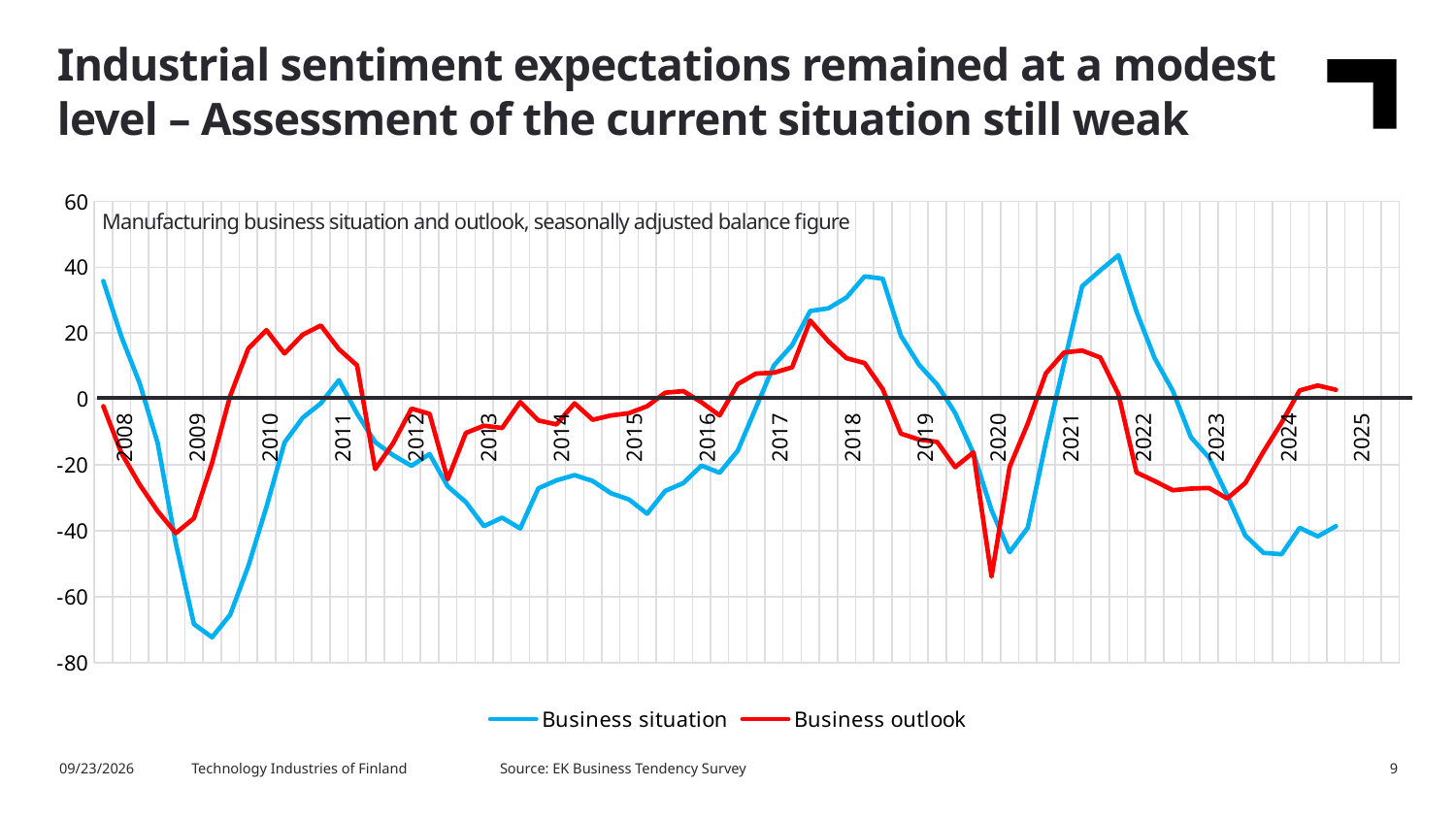
How many year labels are shown on the x axis? 18 Does the Business situation line rise or fall between 2022 and 2024? Fall How many series does the legend list? 2 What are the two series named in the legend? Business situation and Business outlook What kind of chart is shown on the slide? Line chart Around 2009, which series reaches the lower value, Business situation or Business outlook? Business situation Is the lowest value of the Business situation line, around 2009, greater or less than -60? less What colour is the Business outlook line? Red Is the highest value of the Business situation line, around 2021-2022, greater or less than 20? greater At the end of the series in 2025, which line is higher, Business situation or Business outlook? Business outlook Is the Business situation value at the end of the series in 2025 greater or less than -20? less